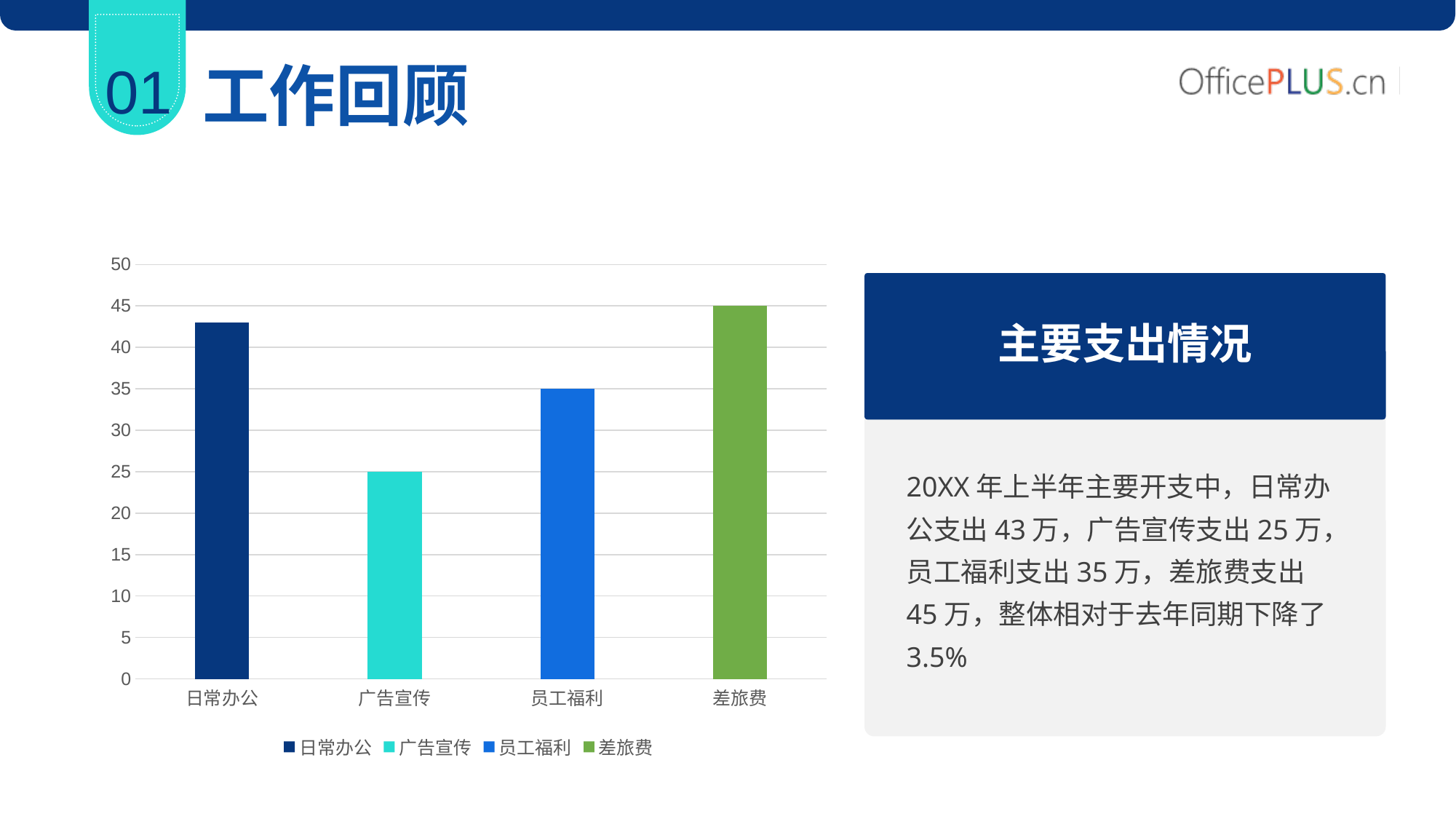
Is the value for 日常办公 greater or less than 40? greater Which category has the lowest bar in the chart? 广告宣传 What colour is the bar for 差旅费 in the chart? green Which is larger, the value for 日常办公 or the value for 员工福利? 日常办公 What is the value for 员工福利 in the chart? 35 What is the difference between the values for 差旅费 and 广告宣传? 20 How many entries does the chart's legend list? 4 What is the value for 差旅费 in the chart? 45 What kind of chart is shown on the slide? bar chart Which category has the highest bar in the chart? 差旅费 How many categories are plotted on the x axis of the chart? 4 What is the value for 广告宣传 in the chart? 25